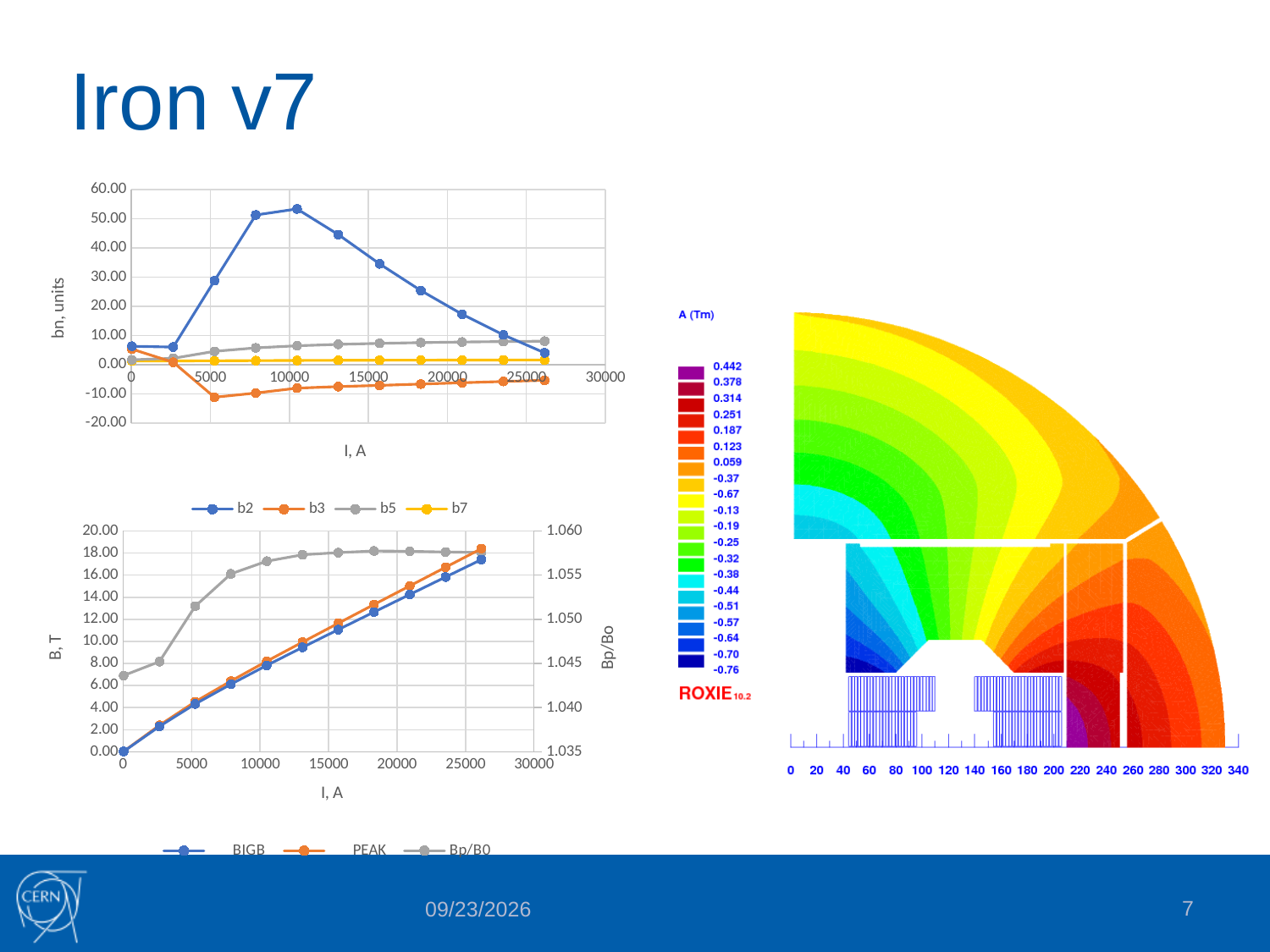
In the top-left chart (bn, units), is the value of b2 at 5000 A greater or less than 20.00? greater In the bottom-left chart (B, T), does the BIGB series rise or fall as I increases? rise In the top-left chart (bn, units), does the b2 series rise or fall between 10000 A and 25000 A? fall What is the x-axis title of the top-left chart? I, A What kind of chart is the top-left chart with y axis 'bn, units'? line chart In the bottom-left chart, is the Bp/B0 value at 15000 A greater or less than 1.055 on the right axis? greater In the top-left chart (bn, units), which series reaches the lowest value? b3 How many series does the legend of the bottom-left chart (B, T) list? 3 In the top-left chart (bn, units), is the value of b3 at 5000 A greater or less than 0.00? less In the top-left chart (bn, units), which series reaches the highest value? b2 How many series does the legend of the top-left chart (bn, units) list? 4